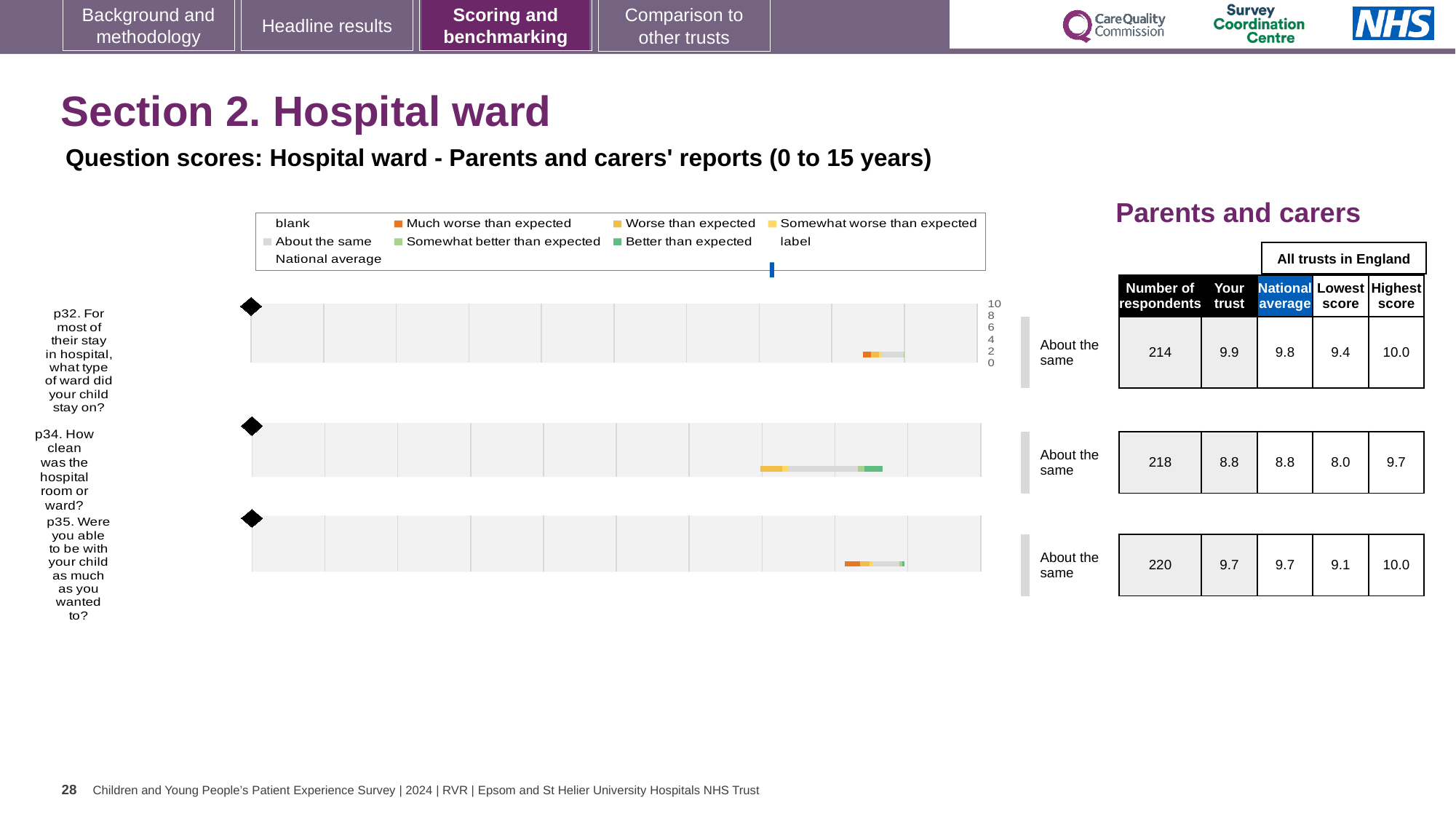
Which legend entry is shown in dark green? Better than expected What kind of chart is used to show the question scores? bar chart Which is larger, the lowest score for p34 or the lowest score for p35? p35 (9.1) Which question has the lowest 'Your trust' score? p34 What is the difference between the 'Your trust' score and the national average for p32? 0.1 How many survey questions are plotted on the slide? 3 What is the national average score for p32 (For most of their stay in hospital, what type of ward did your child stay on)? 9.8 Is the 'Your trust' score for p34 greater or less than 8? greater Which question has the highest 'Your trust' score? p32 What is the difference between the highest score and the lowest score for p34? 1.7 How many respondents answered p35 (Were you able to be with your child as much as you wanted to)? 220 What is the 'Your trust' score for p34 (How clean was the hospital room or ward)? 8.8